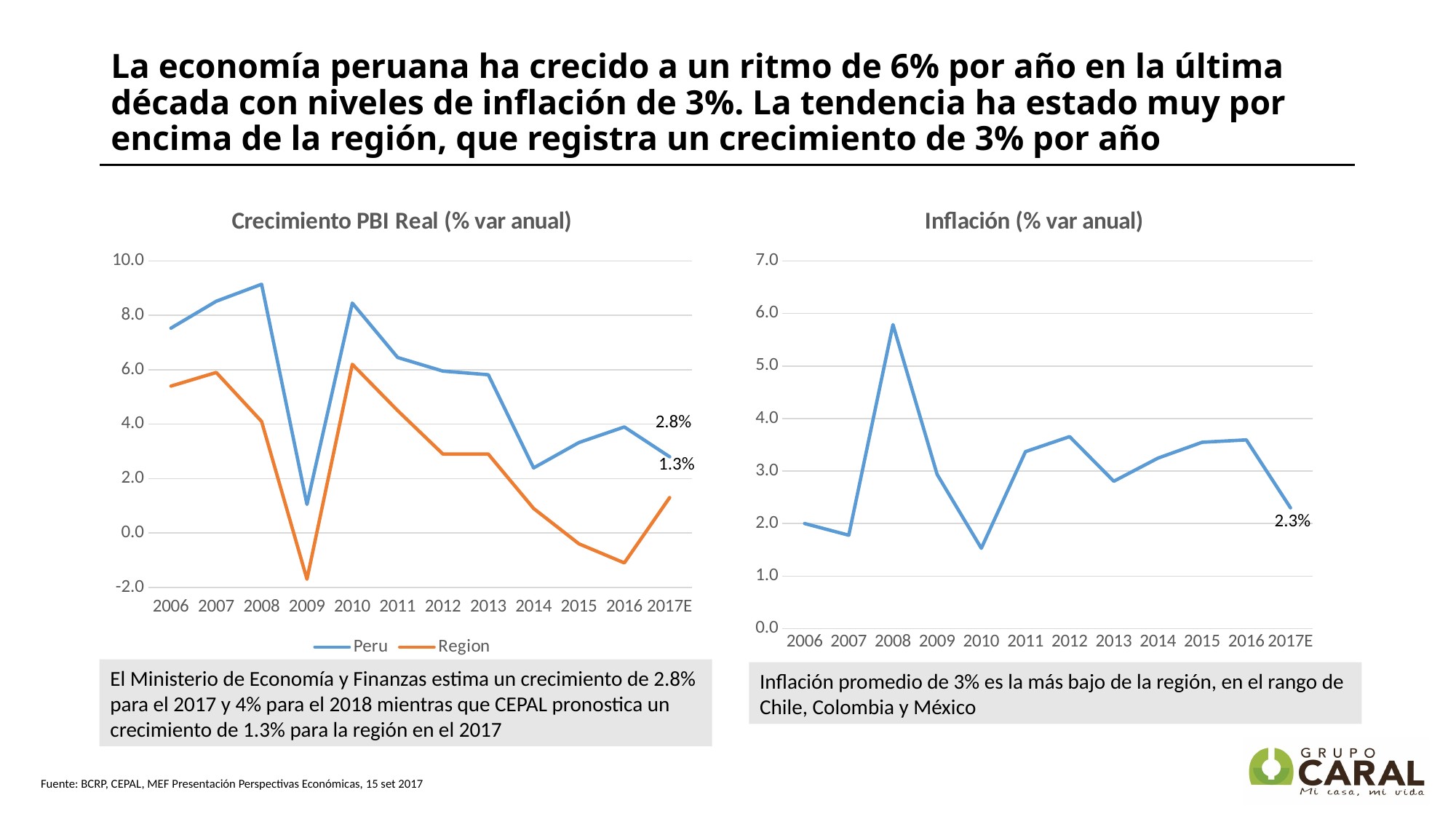
In the 'Crecimiento PBI Real (% var anual)' chart, in which year is the Peru series at its highest? 2008 In the 'Crecimiento PBI Real (% var anual)' chart, in which year is the Region series at its lowest? 2009 In the 'Inflación (% var anual)' chart, is the value for 2008 greater or less than 5.0? greater In the 'Crecimiento PBI Real (% var anual)' chart, which series has the higher value in 2009, Peru or Region? Peru In the 'Crecimiento PBI Real (% var anual)' chart, is the value for Region in 2009 greater or less than 0.0? less In the 'Crecimiento PBI Real (% var anual)' chart, what is the value for Peru in 2017E? 2.8% How many series does the legend of the 'Crecimiento PBI Real (% var anual)' chart list? 2 In the 'Crecimiento PBI Real (% var anual)' chart, what is the value for Region in 2017E? 1.3% In the 'Crecimiento PBI Real (% var anual)' chart, what is the difference between the Peru and Region values in 2017E? 1.5% What kind of chart is the 'Crecimiento PBI Real (% var anual)' chart? line chart In the 'Inflación (% var anual)' chart, which year has the highest value? 2008 In the 'Inflación (% var anual)' chart, what is the value for 2017E? 2.3%